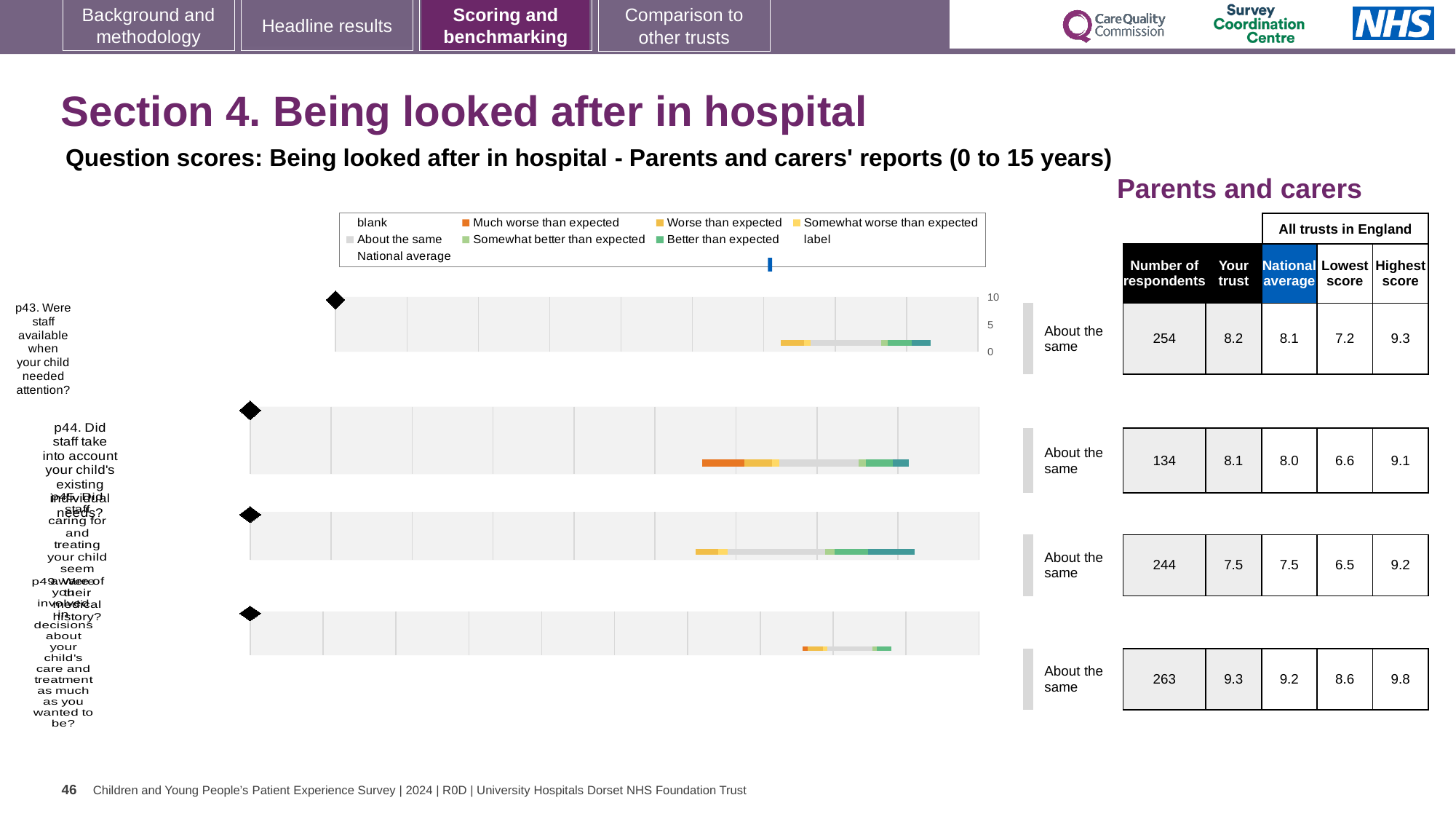
What does the blue marker in the legend represent? National average Which question has the lowest number of respondents? p44 What is the difference between the highest score and the lowest score for question p44? 2.5 What is the highest score among all trusts in England for question p44? 9.1 What is the national average score for question p45 (Did staff caring for and treating your child seem aware of their medical history?)? 7.5 How many question charts are shown on the slide? 4 What is the 'Your trust' score for question p49 (Were you involved in decisions about your child's care and treatment as much as you wanted to be?)? 9.3 For question p43, is the 'Your trust' score higher or lower than the national average? higher Which question has the highest 'Your trust' score? p49 Which legend entry is shown in dark orange? Much worse than expected What is the number of respondents for question p43 (Were staff available when your child needed attention?)? 254 What kind of chart is used to show the benchmark results for question p43? bar chart